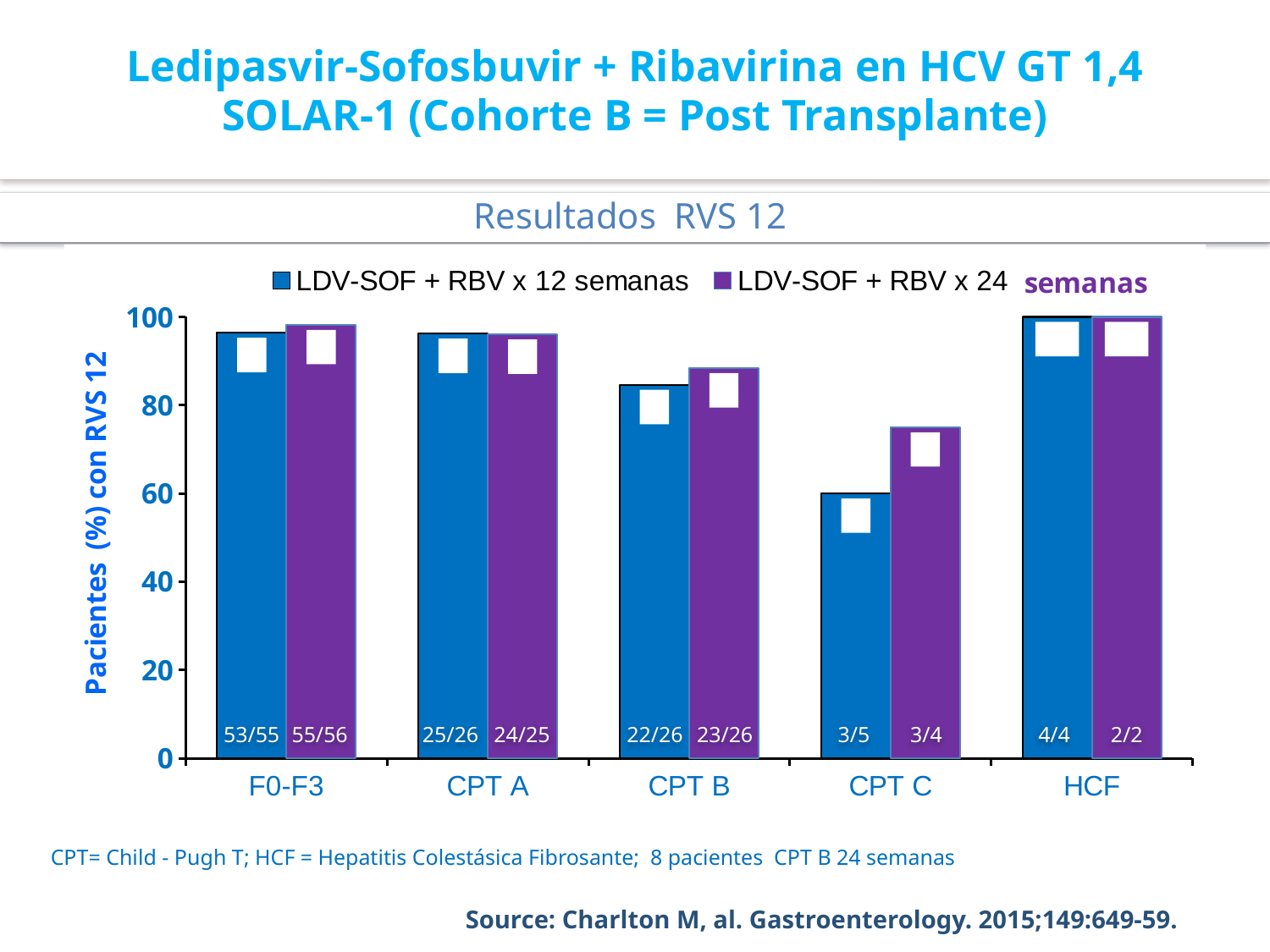
What fraction label is printed on the LDV-SOF + RBV x 12 semanas bar for F0-F3? 53/55 How many categories are shown on the x axis of the chart? 5 What kind of chart is shown on the slide? bar chart Is the value for the LDV-SOF + RBV x 12 semanas bar in CPT B greater or less than 80? greater Which category has the highest bars in the chart? HCF For CPT C, which series has the larger value: LDV-SOF + RBV x 12 semanas or LDV-SOF + RBV x 24 semanas? LDV-SOF + RBV x 24 semanas Is the value for the LDV-SOF + RBV x 24 semanas bar in CPT C greater or less than 80? less Which category has the lowest bar for the LDV-SOF + RBV x 12 semanas series? CPT C What fraction label is printed on the LDV-SOF + RBV x 12 semanas bar for CPT C? 3/5 How many series does the chart legend list? 2 What fraction label is printed on the LDV-SOF + RBV x 24 semanas bar for CPT B? 23/26 What is the title of the y axis of the chart? Pacientes (%) con RVS 12